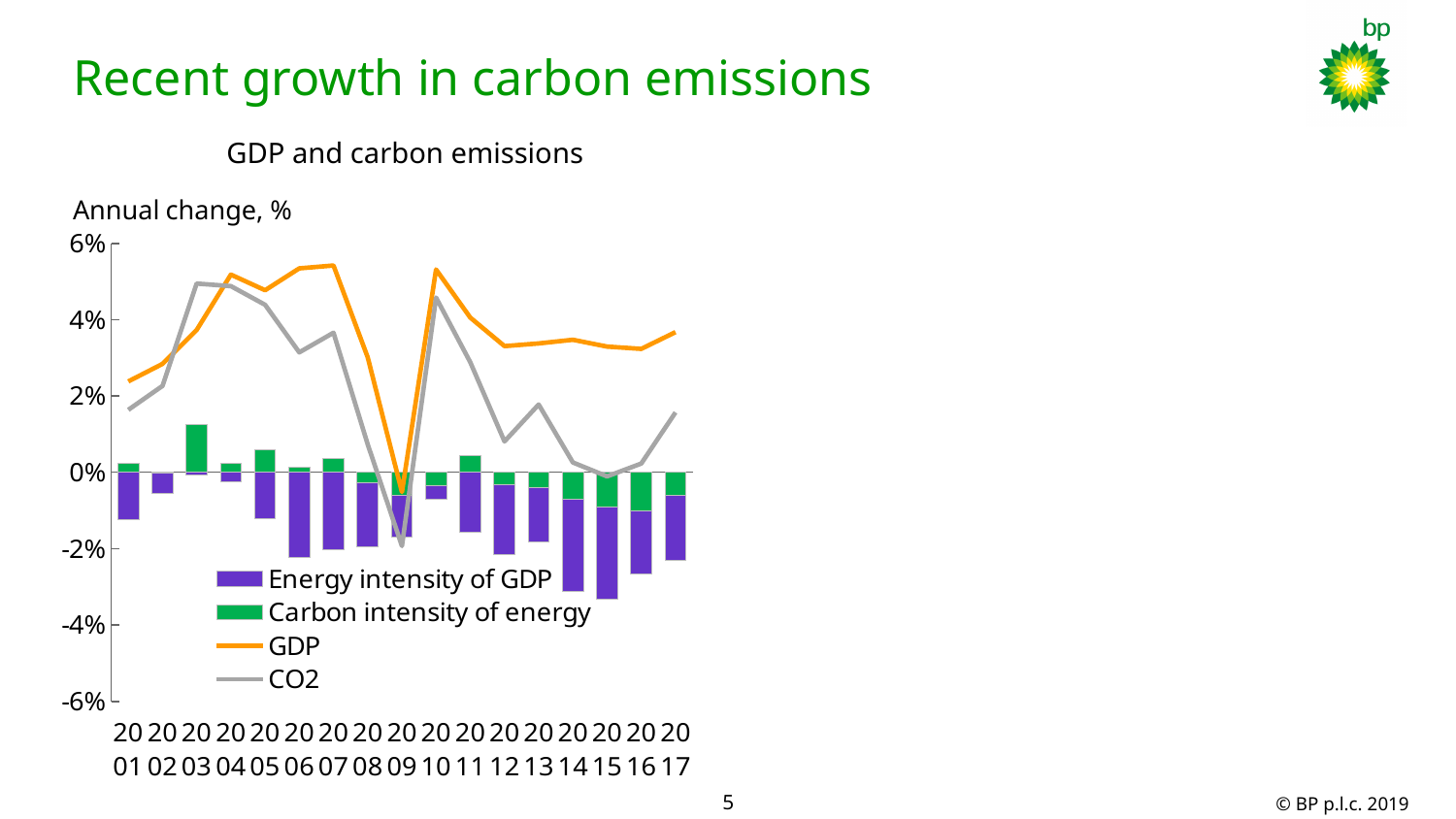
In which year is the GDP line at its lowest? 2009 How many series does the chart's legend list? 4 In which year is the CO2 line at its lowest? 2009 Is the GDP value for 2007 greater or less than 4%? greater In which year is the Carbon intensity of energy bar at its highest? 2003 Is the Energy intensity of GDP value for 2015 greater or less than -2%? less Is the CO2 value for 2009 greater or less than 0%? less What colour is the GDP line in the chart? Orange What is the title of the chart? GDP and carbon emissions In 2012, which is larger, the GDP value or the CO2 value? GDP What kind of chart is shown on the slide? Combination bar and line chart How many years are shown on the x axis of the chart? 17